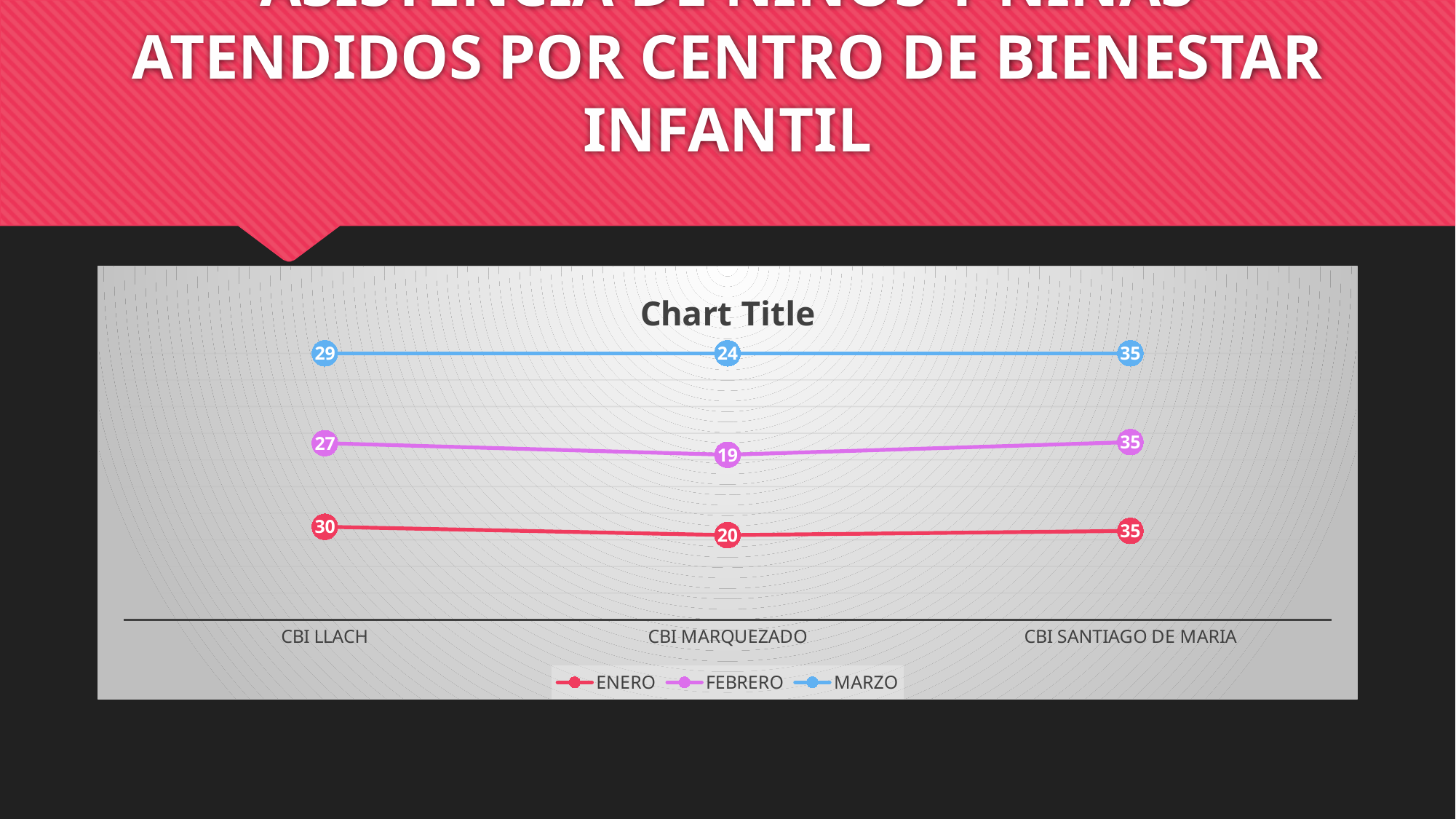
What is the FEBRERO value for CBI LLACH? 27 What is the MARZO value for CBI MARQUEZADO? 24 What is the ENERO value for CBI MARQUEZADO? 20 Which centre has the highest ENERO value? CBI SANTIAGO DE MARIA How many series does the legend list? 3 What kind of chart is shown on the slide? line chart What is the MARZO value for CBI SANTIAGO DE MARIA? 35 What is the difference between the ENERO values for CBI SANTIAGO DE MARIA and CBI MARQUEZADO? 15 Which centre has the lowest FEBRERO value? CBI MARQUEZADO For CBI LLACH, which is larger: the ENERO value or the FEBRERO value? ENERO How many centres (categories) are shown on the x axis? 3 What title is printed above the chart? Chart Title